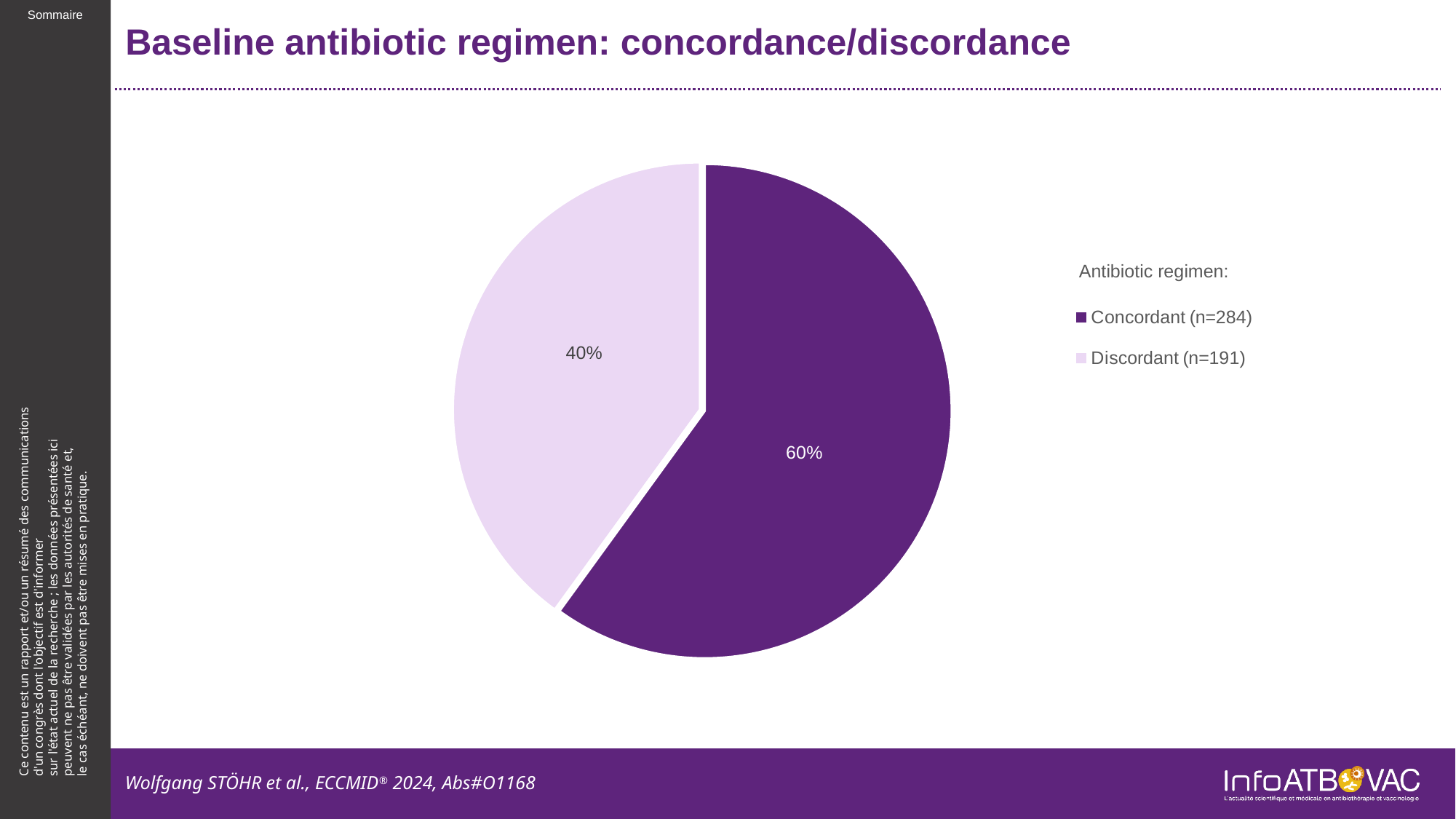
Which slice is the largest in the pie chart? Concordant (n=284) What share of the pie does the Concordant slice represent? 60% What is the title of the chart on the slide? Baseline antibiotic regimen: concordance/discordance What kind of chart is shown on the slide? pie chart Which is larger, the Concordant slice or the Discordant slice? Concordant Which slice is the smallest in the pie chart? Discordant (n=191) What share of the pie does the Discordant slice represent? 40% What is the difference in percentage points between the Concordant and Discordant slices? 20% What is the n value shown in the legend for the Discordant group? 191 What is the n value shown in the legend for the Concordant group? 284 How many slices does the pie chart have? 2 How many entries does the legend list? 2